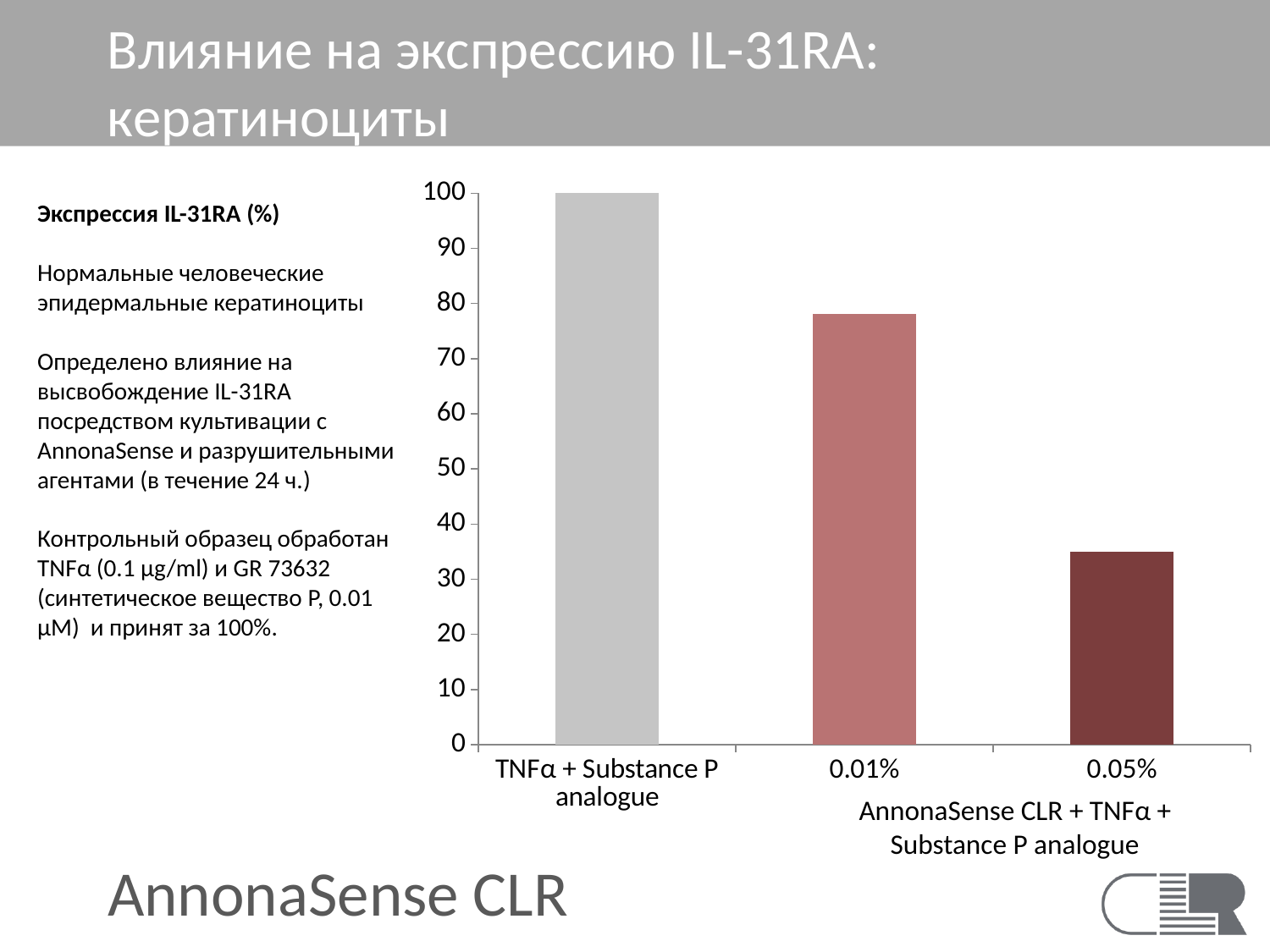
Which is larger, the value for 0.01% or the value for 0.05%? 0.01% Which category has the lowest value? 0.05% Do the values rise or fall from left to right along the x axis? fall What kind of chart is shown on the slide? bar chart Is the value for 0.01% greater or less than 70? greater What is the value for TNFα + Substance P analogue? 100 What is the highest value shown on the vertical axis? 100 Is the value for 0.05% greater or less than 40? less Is the value for 0.01% greater or less than 80? less How many bars are plotted in the chart? 3 Which category has the highest value? TNFα + Substance P analogue